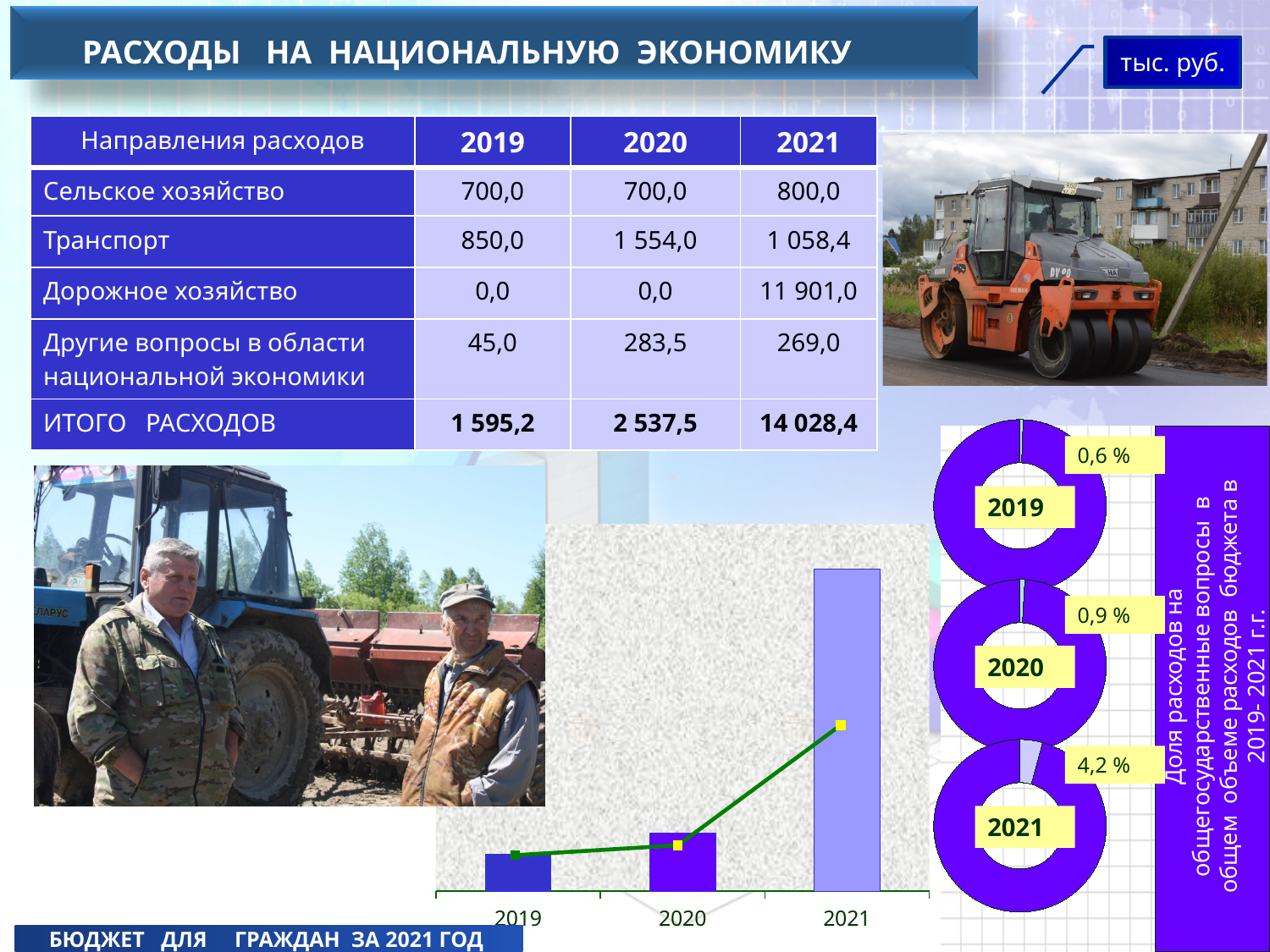
How many donut charts are shown on the right of the slide? 3 In the donut charts on the right of the slide, what share is shown for 2021? 4,2 % In the bar chart at the bottom centre of the slide, which year has the shortest bar? 2019 Among the donut charts on the right of the slide, which year shows the largest share? 2021 In the bar chart at the bottom centre of the slide, do the bars rise or fall from 2019 to 2021? rise How many categories are shown on the x axis of the bar chart at the bottom centre of the slide? 3 What kind of chart is the chart at the bottom centre of the slide with categories 2019, 2020 and 2021? bar chart with a line In the donut charts on the right of the slide, what share is shown for 2020? 0,9 % In the bar chart at the bottom centre of the slide, which year has the tallest bar? 2021 In the bar chart at the bottom centre of the slide, which year's bar is drawn in a lighter shade than the others? 2021 In the bar chart at the bottom centre of the slide, is the bar for 2020 taller or shorter than the bar for 2019? taller In the donut charts on the right of the slide, what share is shown for 2019? 0,6 %